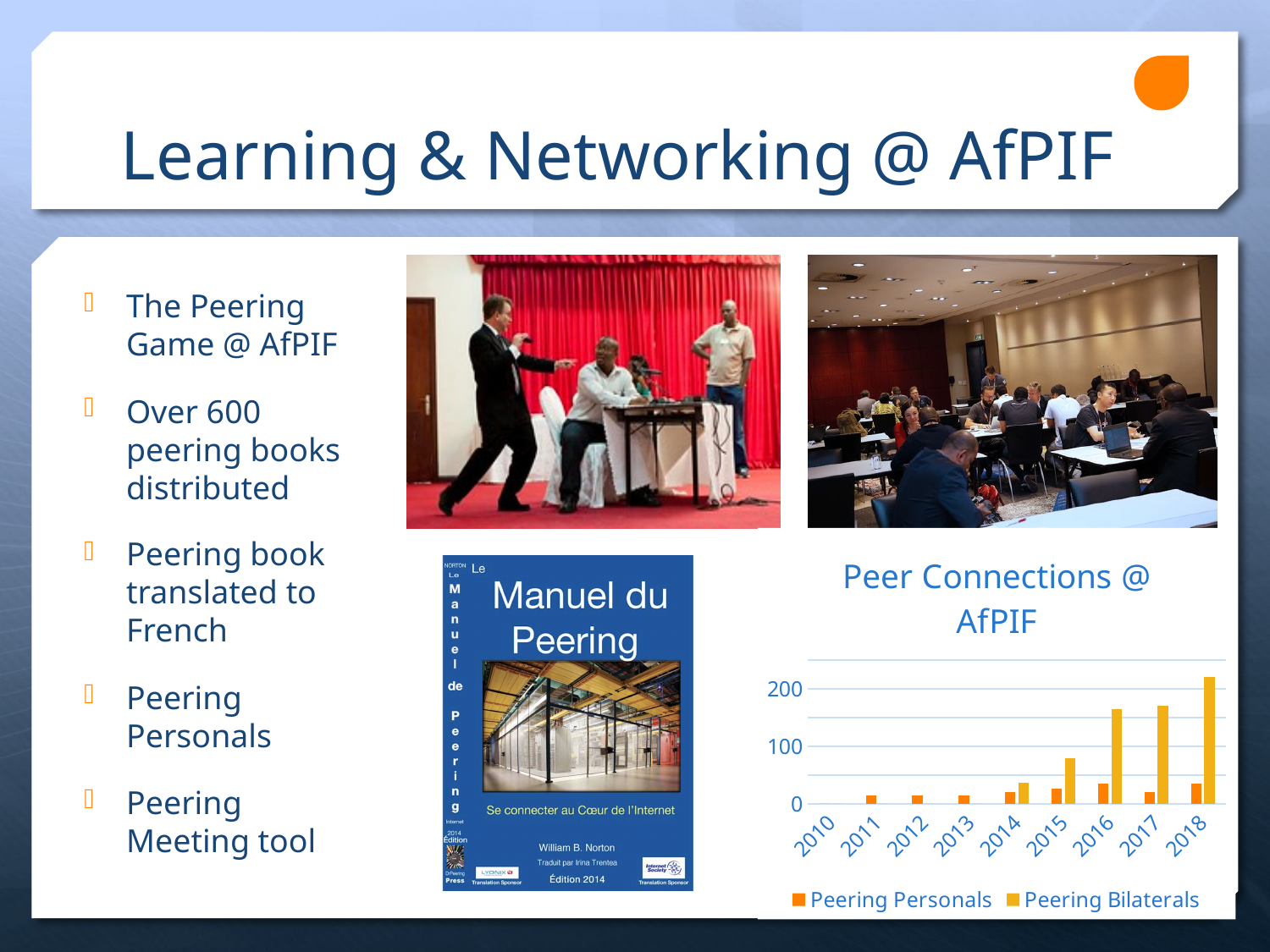
In the "Peer Connections @ AfPIF" chart, which year has the larger Peering Bilaterals value, 2015 or 2018? 2018 What kind of chart is "Peer Connections @ AfPIF"? bar chart In the "Peer Connections @ AfPIF" chart, which series has the larger value in 2018, Peering Personals or Peering Bilaterals? Peering Bilaterals In the "Peer Connections @ AfPIF" chart, is the Peering Personals value for 2016 greater or less than 100? less How many years are shown on the x axis of the "Peer Connections @ AfPIF" chart? 9 What are the two series listed in the legend of the "Peer Connections @ AfPIF" chart? Peering Personals and Peering Bilaterals In the "Peer Connections @ AfPIF" chart, is the Peering Bilaterals value for 2016 greater or less than 100? greater In the "Peer Connections @ AfPIF" chart, do the Peering Bilaterals values generally rise or fall from 2011 to 2018? rise In the "Peer Connections @ AfPIF" chart, is the Peering Bilaterals value for 2015 greater or less than 100? less How many series does the legend of the "Peer Connections @ AfPIF" chart list? 2 In the "Peer Connections @ AfPIF" chart, which year has the highest Peering Bilaterals value? 2018